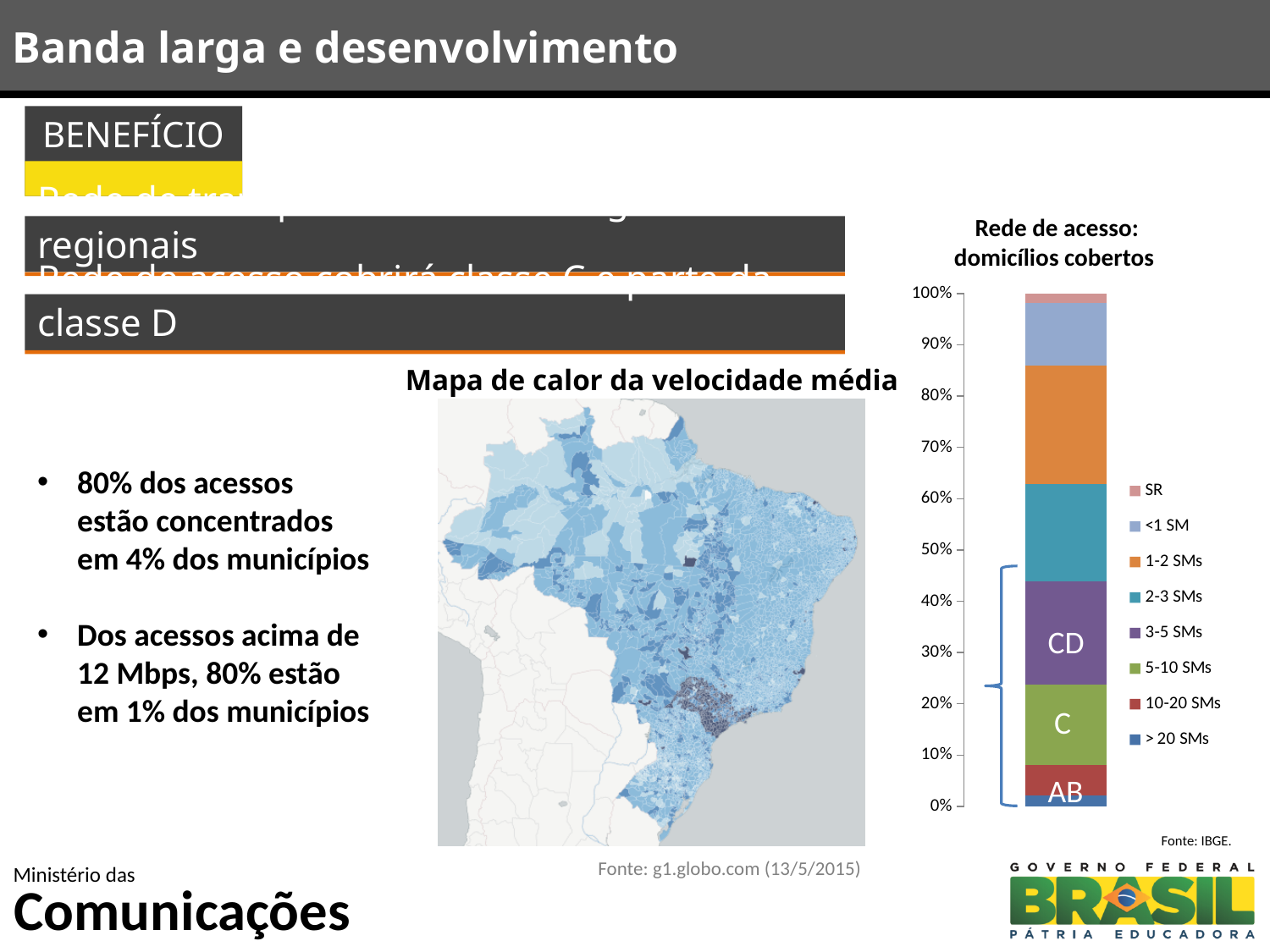
What is the highest value shown on the vertical axis of the 'Rede de acesso: domicílios cobertos' chart? 100% In the 'Rede de acesso: domicílios cobertos' chart, which segment is larger: 3-5 SMs or SR? 3-5 SMs In the 'Rede de acesso: domicílios cobertos' chart, is the share of the 3-5 SMs segment greater or less than 10%? greater In the 'Rede de acesso: domicílios cobertos' chart, is the share of the > 20 SMs segment greater or less than 10%? less What kind of chart is 'Rede de acesso: domicílios cobertos'? stacked bar chart In the 'Rede de acesso: domicílios cobertos' chart, is the share of the SR segment greater or less than 10%? less In the 'Rede de acesso: domicílios cobertos' chart, which segment is larger: 1-2 SMs or <1 SM? 1-2 SMs How many series does the legend of the 'Rede de acesso: domicílios cobertos' chart list? 8 What is the title of the bar chart on the right of the slide? Rede de acesso: domicílios cobertos In the 'Rede de acesso: domicílios cobertos' chart, which legend entry is listed first (at the top)? SR In the 'Rede de acesso: domicílios cobertos' chart, which segment is larger: 5-10 SMs or 10-20 SMs? 5-10 SMs